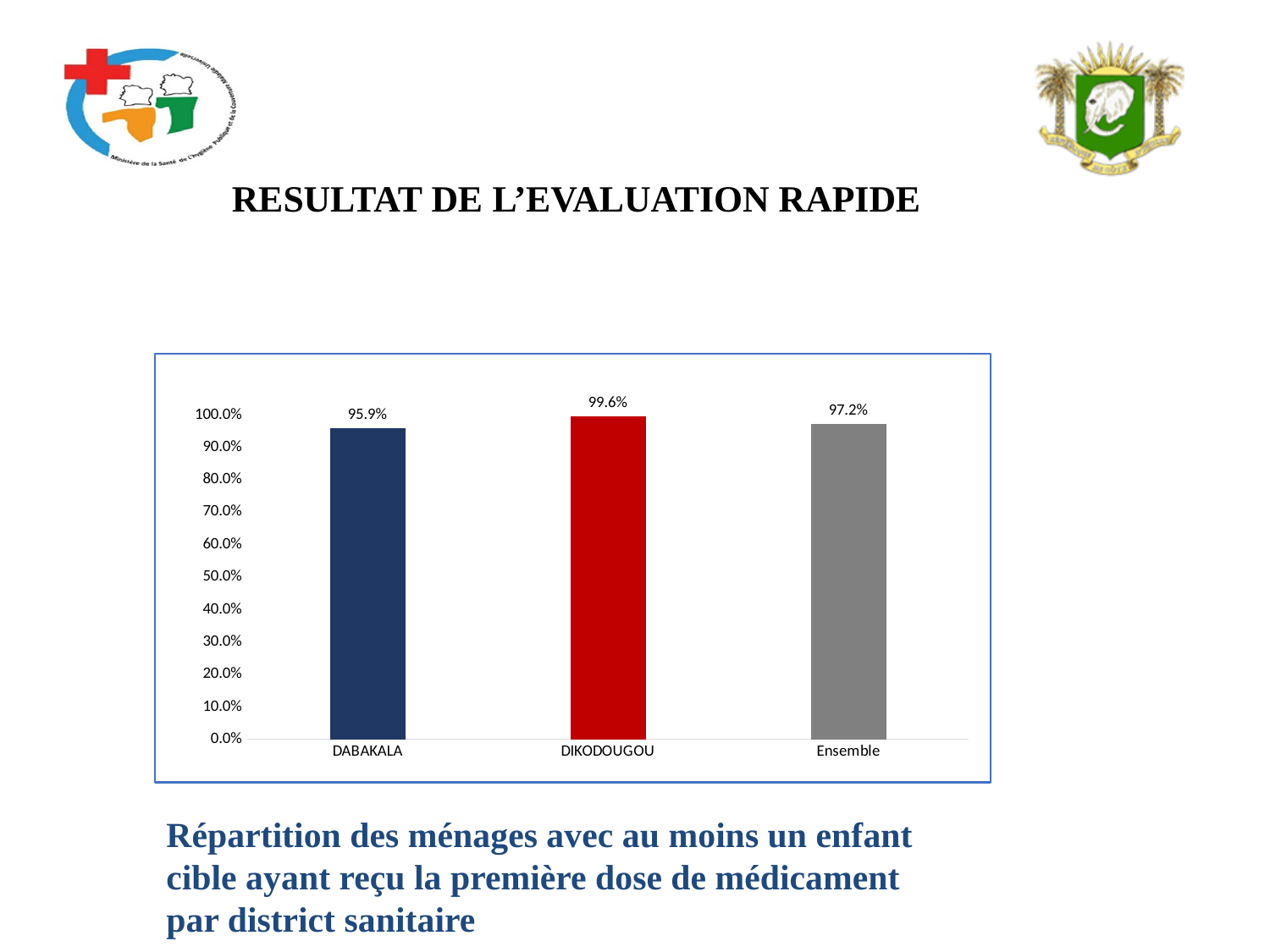
What is the difference between the values for Ensemble and DABAKALA? 1.3% Is the value for DABAKALA greater or less than 90.0%? greater What colour is the bar for DIKODOUGOU? red How many categories are shown on the x axis? 3 Which is larger, the value for DABAKALA or the value for Ensemble? Ensemble Which category has the lowest value? DABAKALA What is the difference between the values for DIKODOUGOU and DABAKALA? 3.7% What is the value for DABAKALA? 95.9% What kind of chart is shown on the slide? bar chart What is the value for Ensemble? 97.2% What is the value for DIKODOUGOU? 99.6% Which category has the highest value? DIKODOUGOU